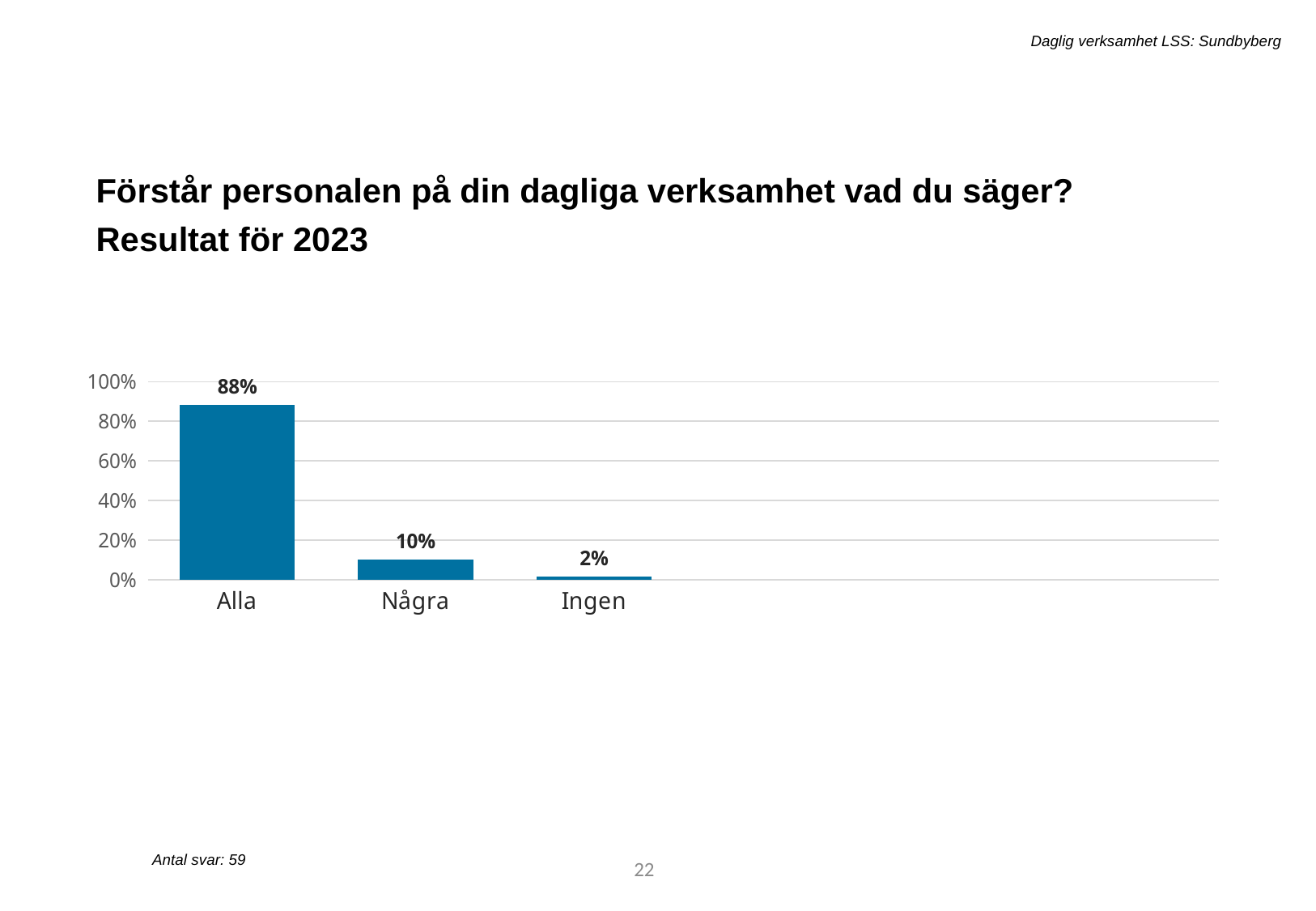
How many categories are shown on the x axis? 3 What kind of chart is shown on the slide? Bar chart Which category has the lowest value? Ingen Which is larger, the value for Några or the value for Ingen? Några What is the difference between the values for Några and Ingen? 8 percentage points Is the value for Alla greater or less than 80%? greater Do the values rise or fall from left to right along the x axis? Fall What is the difference between the values for Alla and Några? 78 percentage points What is the value for Alla? 88% What is the value for Ingen? 2% What is the value for Några? 10% Which category has the highest value? Alla